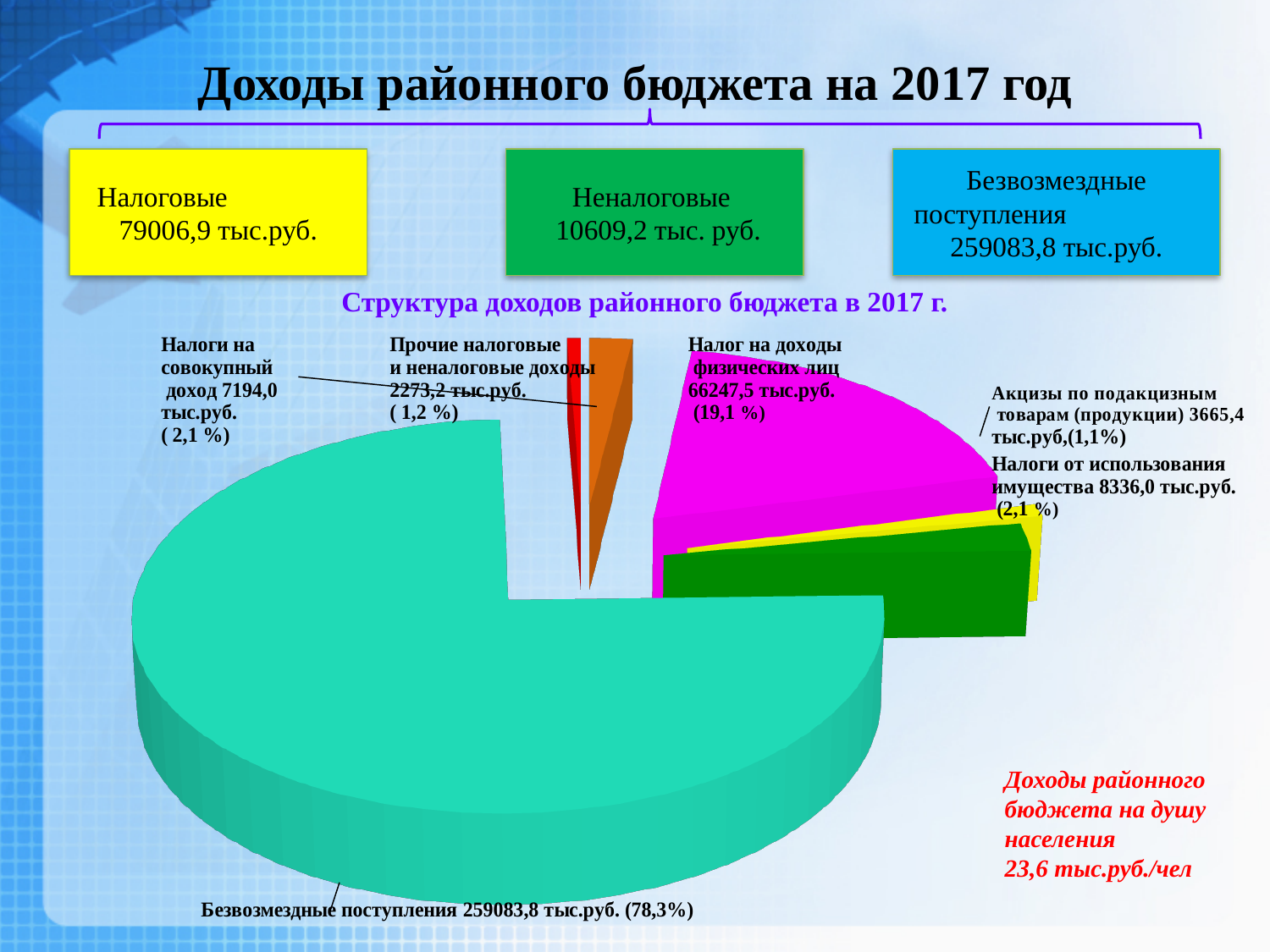
How many slices does the pie chart "Структура доходов районного бюджета в 2017 г." have? 6 What percentage is shown for "Прочие налоговые и неналоговые доходы" in the pie chart? 1,2 % What is the value shown for "Налоги от использования имущества" in the pie chart? 8336,0 тыс.руб. What type of chart is shown under the heading "Структура доходов районного бюджета в 2017 г."? pie chart What percentage is shown for "Налог на доходы физических лиц" in the pie chart? 19,1 % What is the value shown for "Акцизы по подакцизным товарам (продукции)" in the pie chart? 3665,4 тыс.руб What share of the pie does "Безвозмездные поступления" represent? 78,3% Which slice of the pie chart is the largest? Безвозмездные поступления What is the value shown for "Безвозмездные поступления" in the pie chart? 259083,8 тыс.руб. What is the value shown for "Налог на доходы физических лиц" in the pie chart? 66247,5 тыс.руб. Which is larger in the pie chart: "Налоги на совокупный доход" or "Налоги от использования имущества"? Налоги от использования имущества Which slice of the pie chart is the smallest by percentage? Акцизы по подакцизным товарам (продукции)